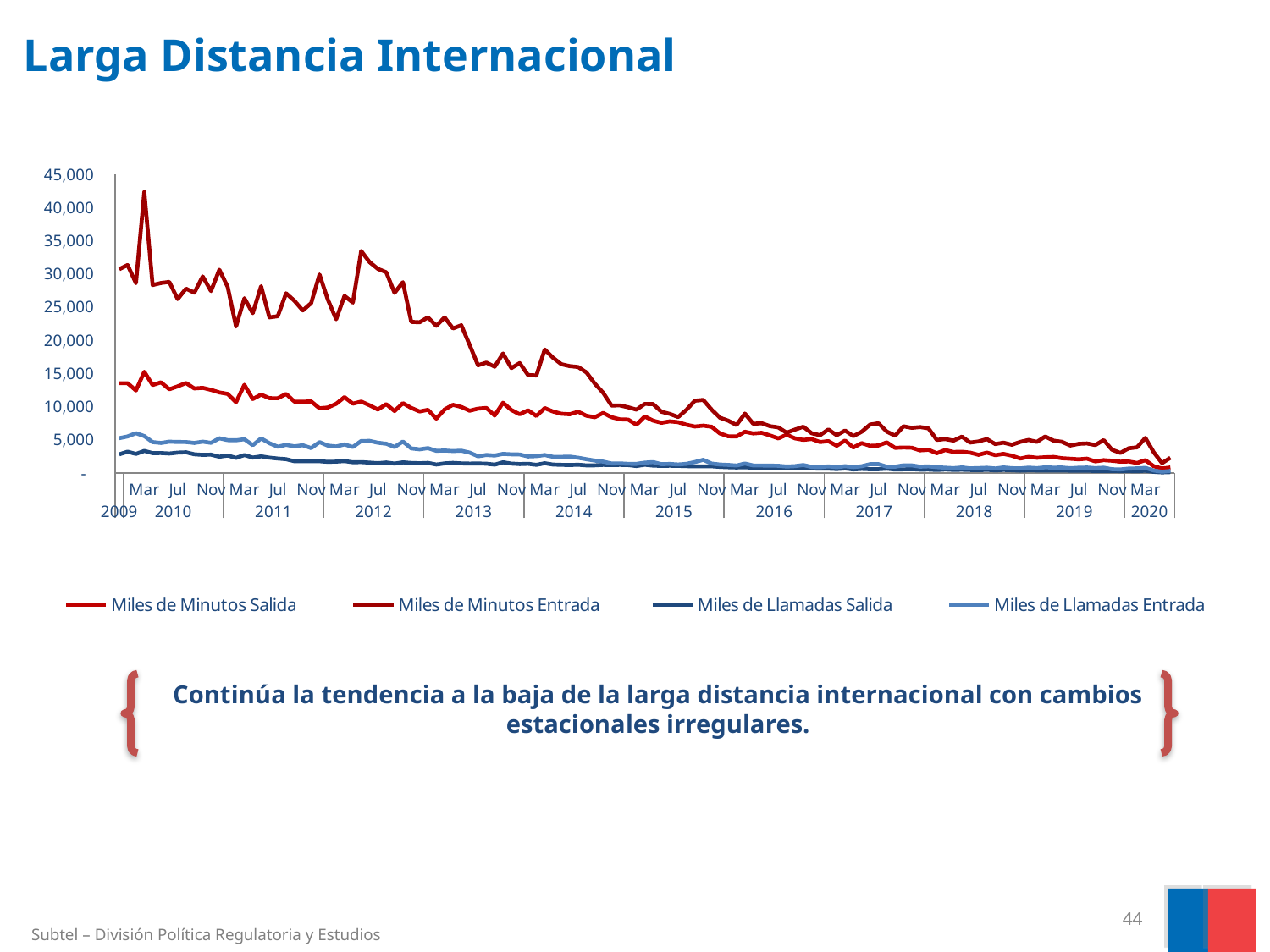
Overall, do the values of the series rise or fall from 2009 to 2020? fall Which year is the first one labelled on the horizontal axis? 2009 Which series is listed last in the chart legend? Miles de Llamadas Entrada How many series does the legend list? 4 What kind of chart is shown on the slide? line chart In 2010, is the value for Miles de Llamadas Entrada higher or lower than the value for Miles de Llamadas Salida? higher In March 2020, is the value of the highest series greater or less than 10,000? less What is the highest value shown on the vertical axis of the chart? 45,000 Is the value for Miles de Llamadas Entrada in 2009 greater or less than 10,000? less Which year is the last one labelled on the horizontal axis? 2020 Is the highest peak reached by any series in 2009 greater or less than 40,000? less What is the title of the slide containing the chart? Larga Distancia Internacional